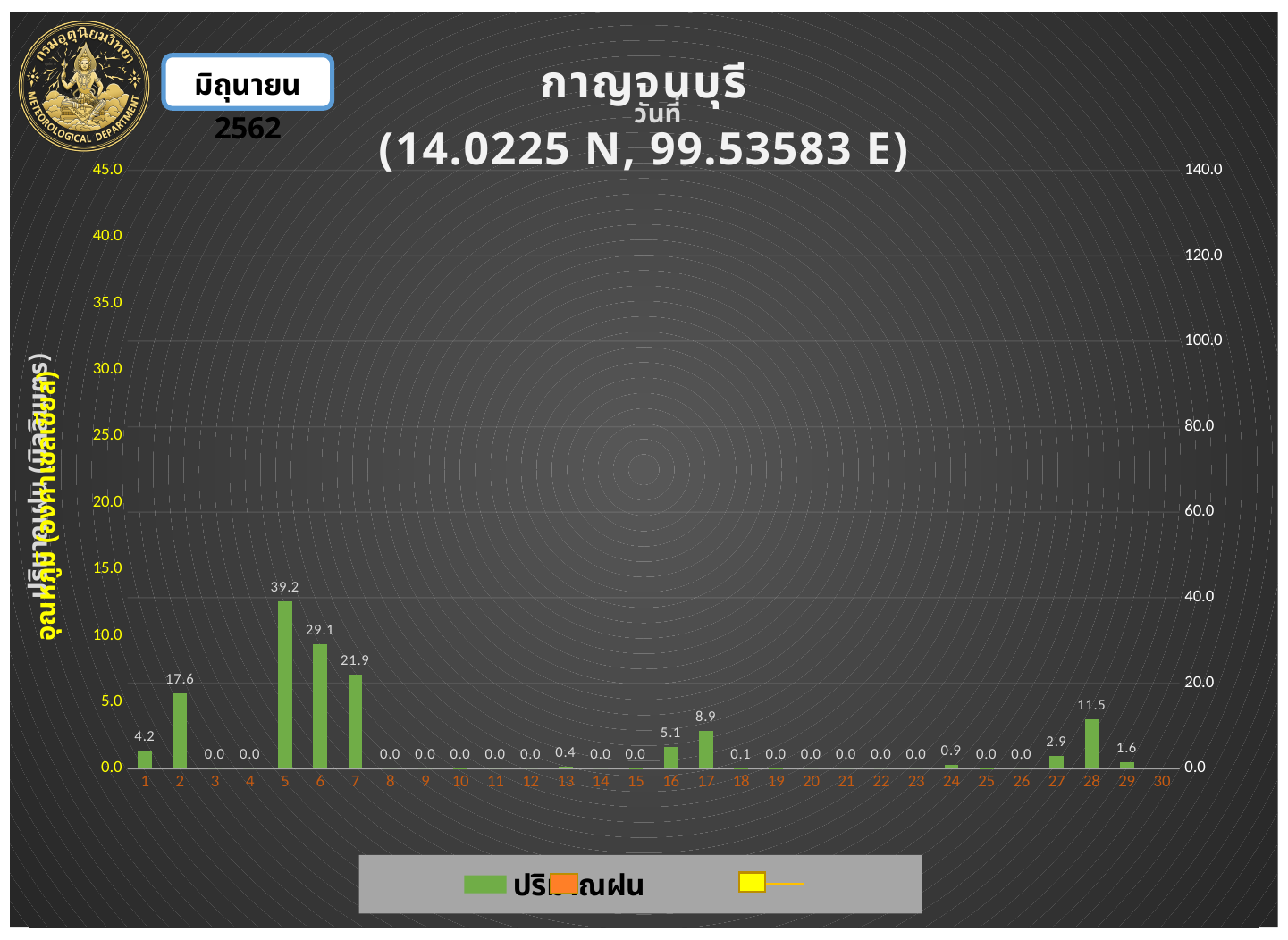
Is the value for day 6 greater or less than 40.0 on the right axis? less What is the rainfall value shown for day 2? 17.6 Do the rainfall values rise or fall from day 5 to day 7? fall What is the difference between the rainfall values for day 5 and day 6? 10.1 What is the rainfall value shown for day 5? 39.2 What kind of chart is shown on the slide? bar chart What is the rainfall value shown for day 17? 8.9 Which day has the highest rainfall value? 5 Which has a larger rainfall value, day 2 or day 7? day 7 What is the rainfall value shown for day 28? 11.5 How many days are shown on the x axis? 30 What coordinates are given in the chart title? 14.0225 N, 99.53583 E